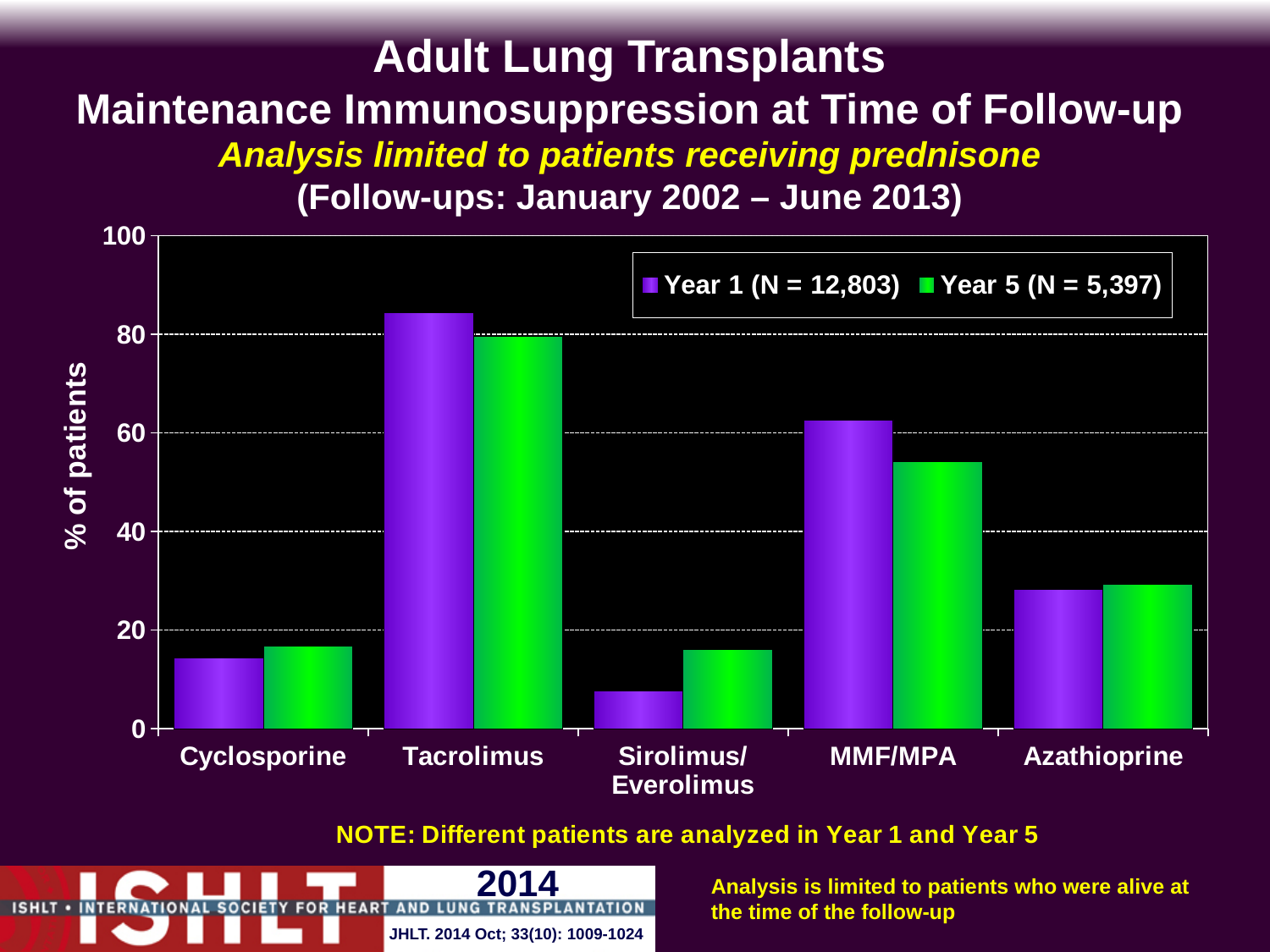
Is the Year 1 value for Tacrolimus greater or less than 80? greater What is the label of the y axis? % of patients Is the Year 5 value for MMF/MPA greater or less than 60? less Which drug has the lowest Year 1 percentage of patients? Sirolimus/Everolimus Which drug has the highest Year 1 percentage of patients? Tacrolimus For MMF/MPA, which is larger: the Year 1 value or the Year 5 value? Year 1 What kind of chart is shown on the slide? bar chart Is the Year 1 value for Sirolimus/Everolimus greater or less than 20? less How many drug categories are shown on the x axis? 5 How many series does the legend list? 2 Which drug has the highest Year 5 percentage of patients? Tacrolimus